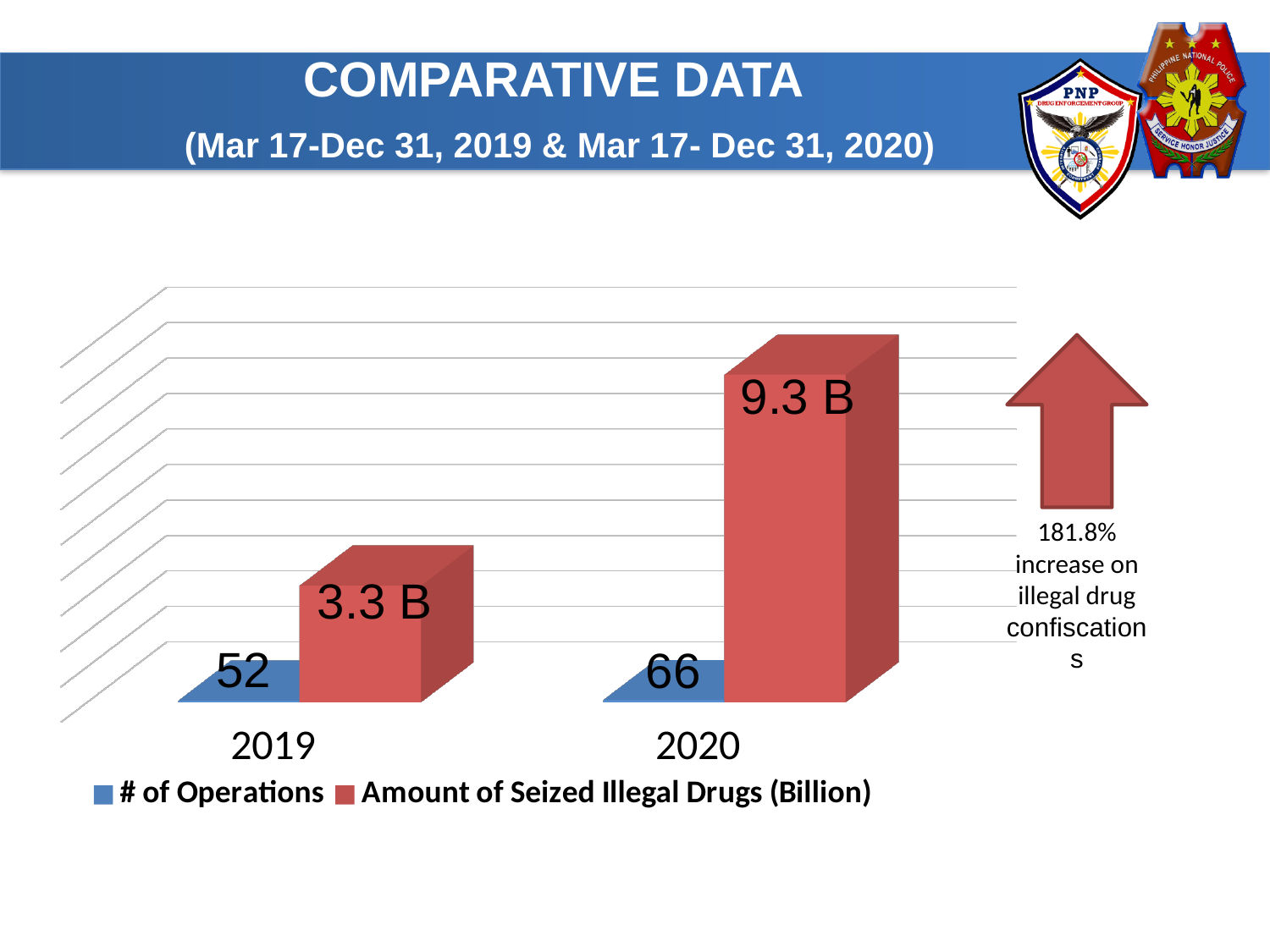
What kind of chart is shown on the slide? Bar chart Which year has the higher amount of seized illegal drugs? 2020 What is the difference in the number of operations between 2020 and 2019? 14 What is the number of operations for 2019? 52 What is the amount of seized illegal drugs for 2019? 3.3 B What is the amount of seized illegal drugs for 2020? 9.3 B What percentage increase in illegal drug confiscations is noted next to the chart? 181.8% How many series does the chart legend list? 2 Which year has the lower number of operations? 2019 Is the number of operations larger in 2019 or 2020? 2020 How many years are shown on the x axis of the chart? 2 What is the number of operations for 2020? 66